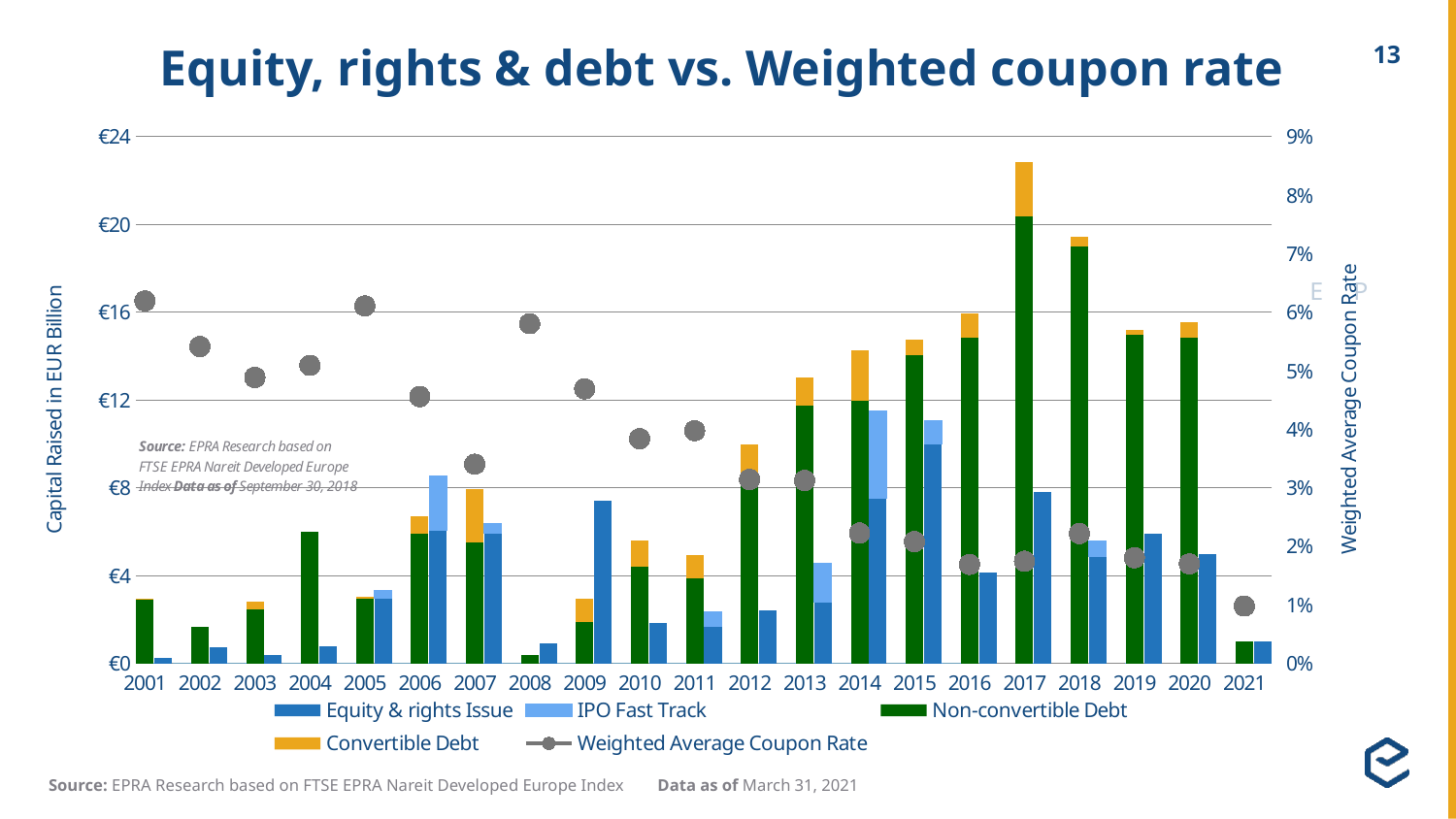
Is the Weighted Average Coupon Rate in 2001 greater or less than 5%? greater Which year has the tallest stacked bar for capital raised? 2017 How many years are shown on the x axis? 21 Is the total capital raised in 2017 greater or less than €20 billion? greater What is the title of the left vertical axis? Capital Raised in EUR Billion Is the Weighted Average Coupon Rate in 2021 greater or less than 2%? less How many series does the legend list? 5 Which year has the larger total capital raised, 2017 or 2018? 2017 Which year has the lowest Weighted Average Coupon Rate? 2021 What type of chart is shown on the slide? Stacked bar chart with a line Does the Weighted Average Coupon Rate generally rise or fall from 2001 to 2021? fall